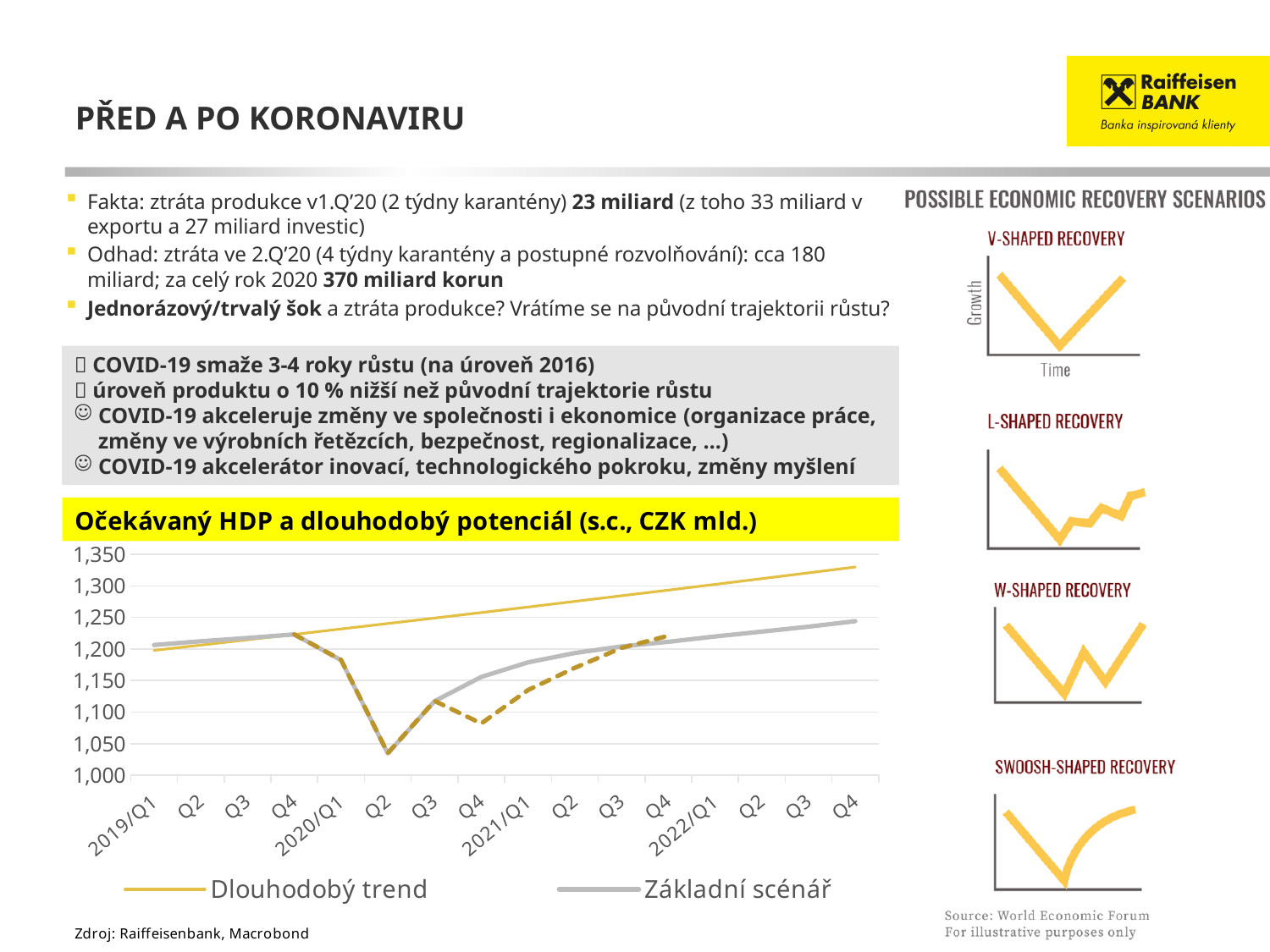
In the 'Očekávaný HDP a dlouhodobý potenciál' chart, is the value of Základní scénář at 2020/Q2 greater or less than 1,100? less In the 'Očekávaný HDP a dlouhodobý potenciál' chart, does the Základní scénář line rise or fall between 2020/Q1 and 2020/Q2? Fall In the 'Očekávaný HDP a dlouhodobý potenciál' chart, is the value of Dlouhodobý trend at 2022/Q4 greater or less than 1,300? greater In the 'Očekávaný HDP a dlouhodobý potenciál' chart, is the value of Dlouhodobý trend at 2021/Q4 greater or less than 1,250? greater How many quarters are shown on the x axis of the 'Očekávaný HDP a dlouhodobý potenciál' chart? 16 What kind of chart is 'Očekávaný HDP a dlouhodobý potenciál (s.c., CZK mld.)'? Line chart In the 'Očekávaný HDP a dlouhodobý potenciál' chart, in which quarter does the Základní scénář line reach its lowest point? 2020/Q2 What source is cited below the 'Očekávaný HDP a dlouhodobý potenciál' chart? Raiffeisenbank, Macrobond In the 'Očekávaný HDP a dlouhodobý potenciál' chart, does the Dlouhodobý trend line rise or fall from 2019/Q1 to 2022/Q4? Rise How many series does the legend of the 'Očekávaný HDP a dlouhodobý potenciál' chart list? 2 In the 'Očekávaný HDP a dlouhodobý potenciál' chart, which series is higher at 2022/Q4, Dlouhodobý trend or Základní scénář? Dlouhodobý trend